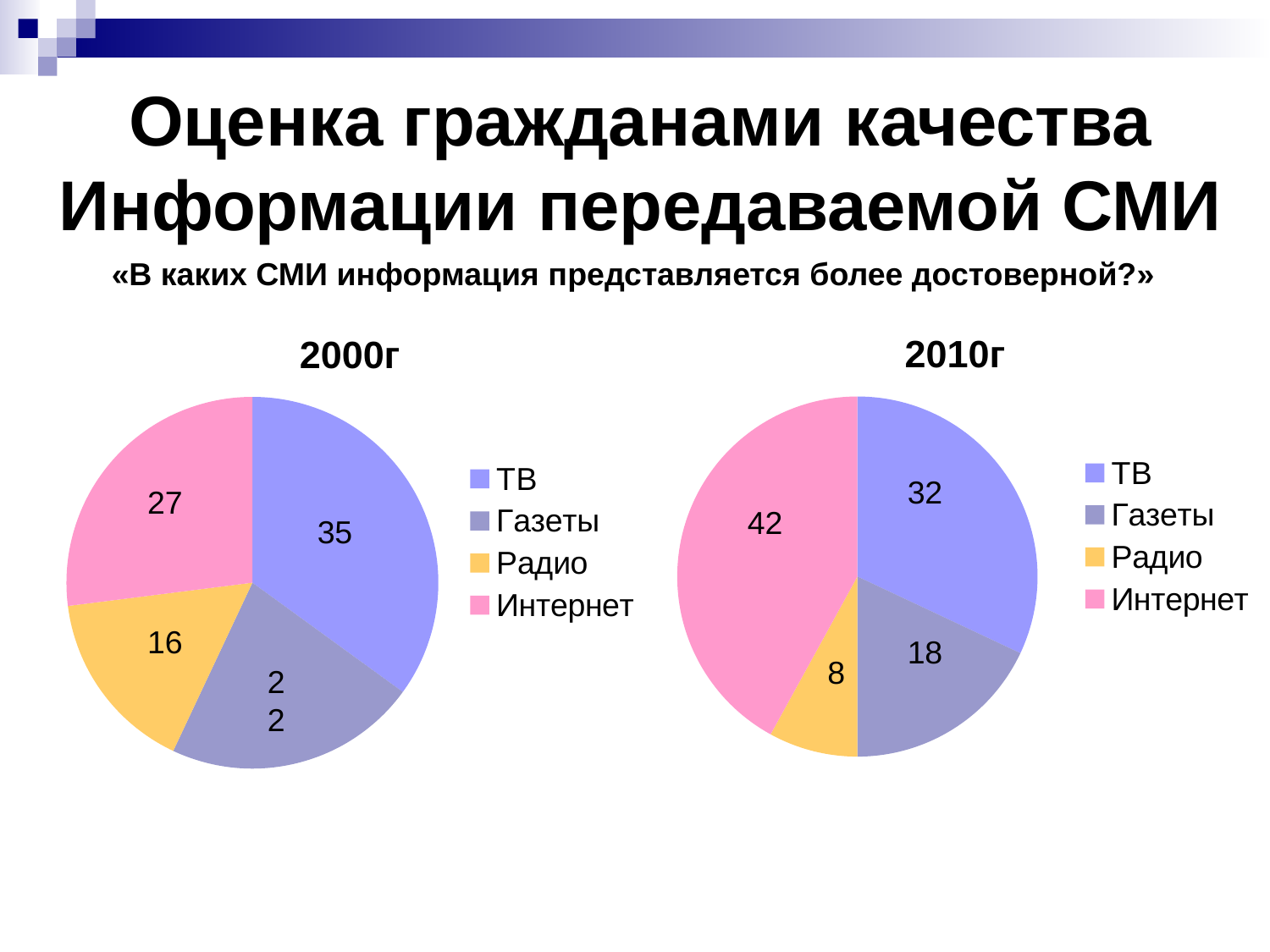
In the 2010г chart, what is the difference between the values for Интернет and ТВ? 10 In the 2000г chart, which category has the smallest slice? Радио In the 2000г chart, what is the difference between the values for ТВ and Газеты? 13 In the 2000г chart, which is larger, the value for Интернет or the value for Газеты? Интернет In the 2000г chart, what is the value for Радио? 16 In the 2010г chart, what is the value for Интернет? 42 In the 2010г chart, which category has the smallest slice? Радио In the 2000г chart, what is the value for ТВ? 35 In the 2010г chart, which category has the largest slice? Интернет How many categories does the 2010г chart show? 4 What type of chart is the 2000г chart? Pie chart In the 2010г chart, what share of the pie does Газеты represent? 18%